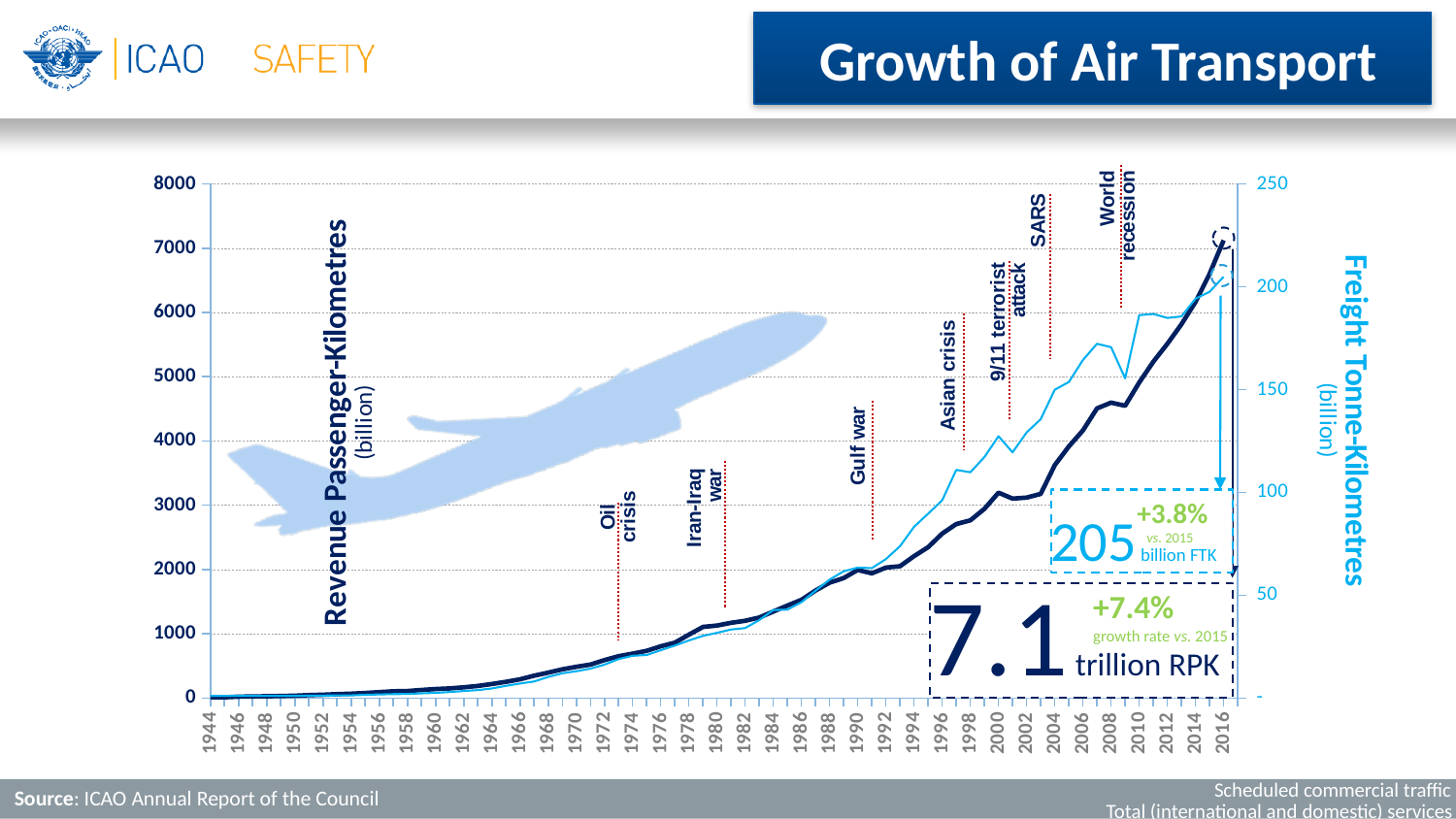
Is the Revenue Passenger-Kilometres value for 1990 greater or less than 3000 billion? less What is the Revenue Passenger-Kilometres value highlighted for 2016? 7.1 trillion RPK What kind of chart is shown on the slide? line chart Do Revenue Passenger-Kilometres rise or fall overall from 1944 to 2016? rise Is the Freight Tonne-Kilometres value for 2000 greater or less than 150 billion? less What is the title of the right-hand vertical axis? Freight Tonne-Kilometres (billion) Is the Revenue Passenger-Kilometres value for 2016 greater or less than 6000 billion? greater What is the Freight Tonne-Kilometres value highlighted for 2016? 205 billion FTK What growth vs. 2015 is shown for Freight Tonne-Kilometres? +3.8% How many historical events are annotated on the chart? 7 What growth rate vs. 2015 is shown for Revenue Passenger-Kilometres? +7.4% In which year do Revenue Passenger-Kilometres reach their highest value? 2016